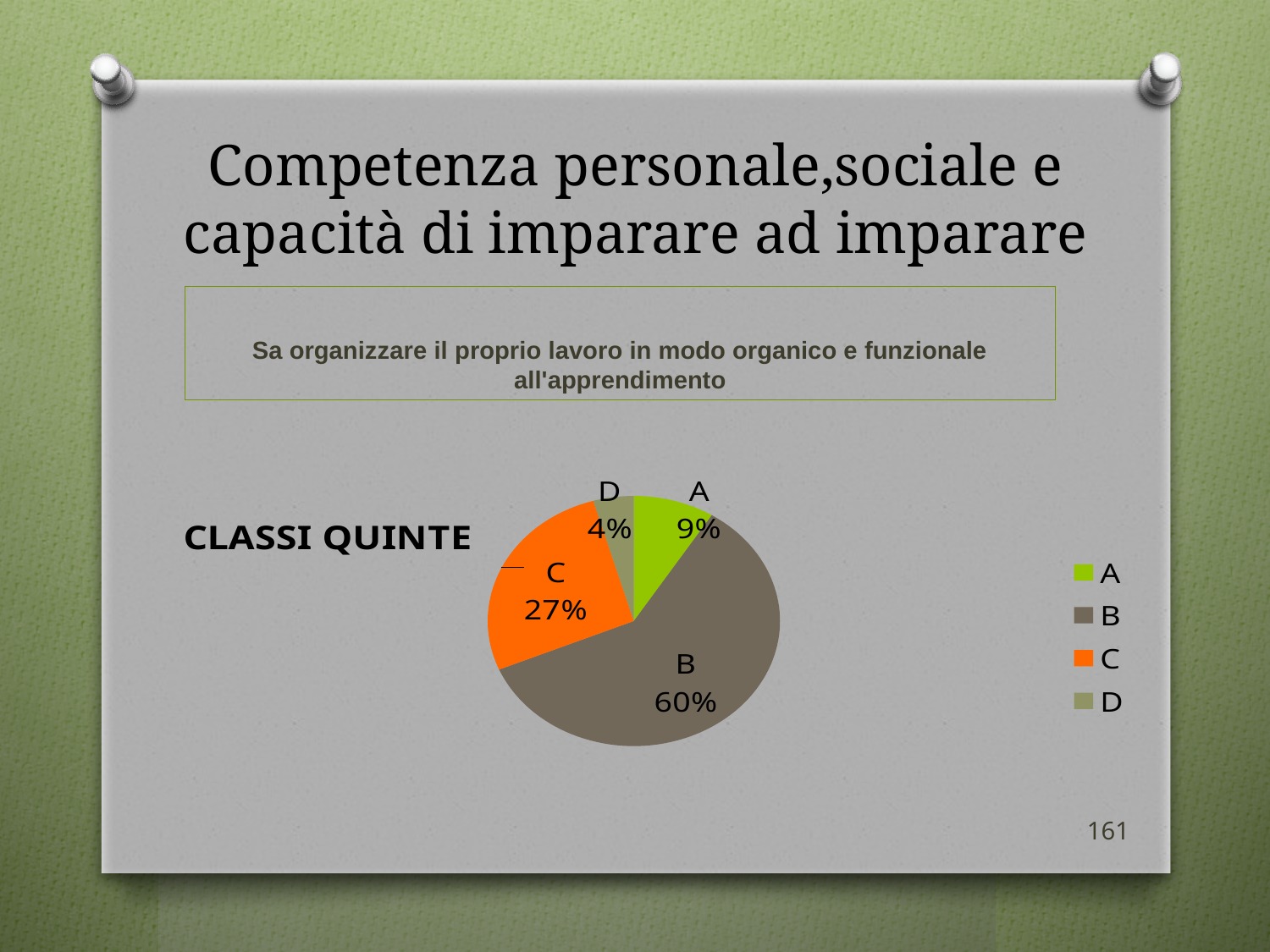
What percentage does slice A represent in the pie chart? 9% How many entries does the legend list? 4 What percentage does slice D represent in the pie chart? 4% What percentage does slice C represent in the pie chart? 27% What type of chart is shown on the slide? pie chart How many slices does the pie chart have? 4 Which category has the smallest share of the pie chart? D What colour is the slice for category C in the pie chart? orange What percentage does slice B represent in the pie chart? 60% Which category has the largest share of the pie chart? B Which is larger, the share for A or the share for C? C What is the difference in percentage points between slice B and slice C? 33